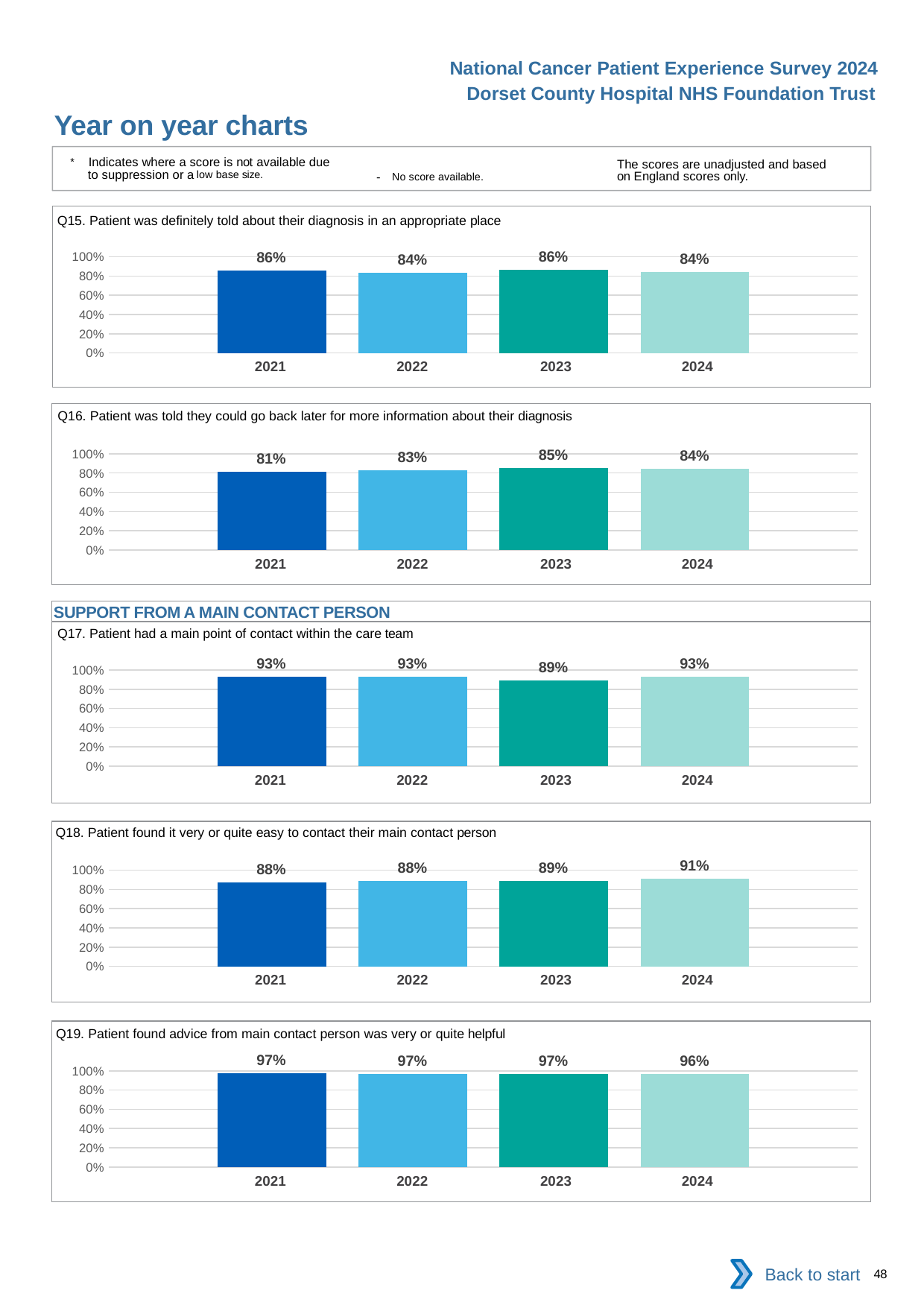
In the Q16 chart, which year has the lowest value? 2021 In the Q15 chart, what is the value for 2022? 84% In the Q18 chart, which year has the highest value? 2024 In the Q17 chart, what is the value for 2024? 93% How many years are shown on the x axis of the Q15 chart? 4 In the Q17 chart, which year has the lowest value? 2023 What kind of chart is the Q18 chart? bar chart In the Q19 chart, what is the value for 2024? 96% In the Q18 chart, is the value for 2021 larger or smaller than the value for 2024? smaller In the Q19 chart, is the value for 2021 greater or less than 80%? greater In the Q16 chart, what is the difference between the 2023 and 2021 values? 4% In the Q16 chart, do the values rise or fall from 2021 to 2023? rise